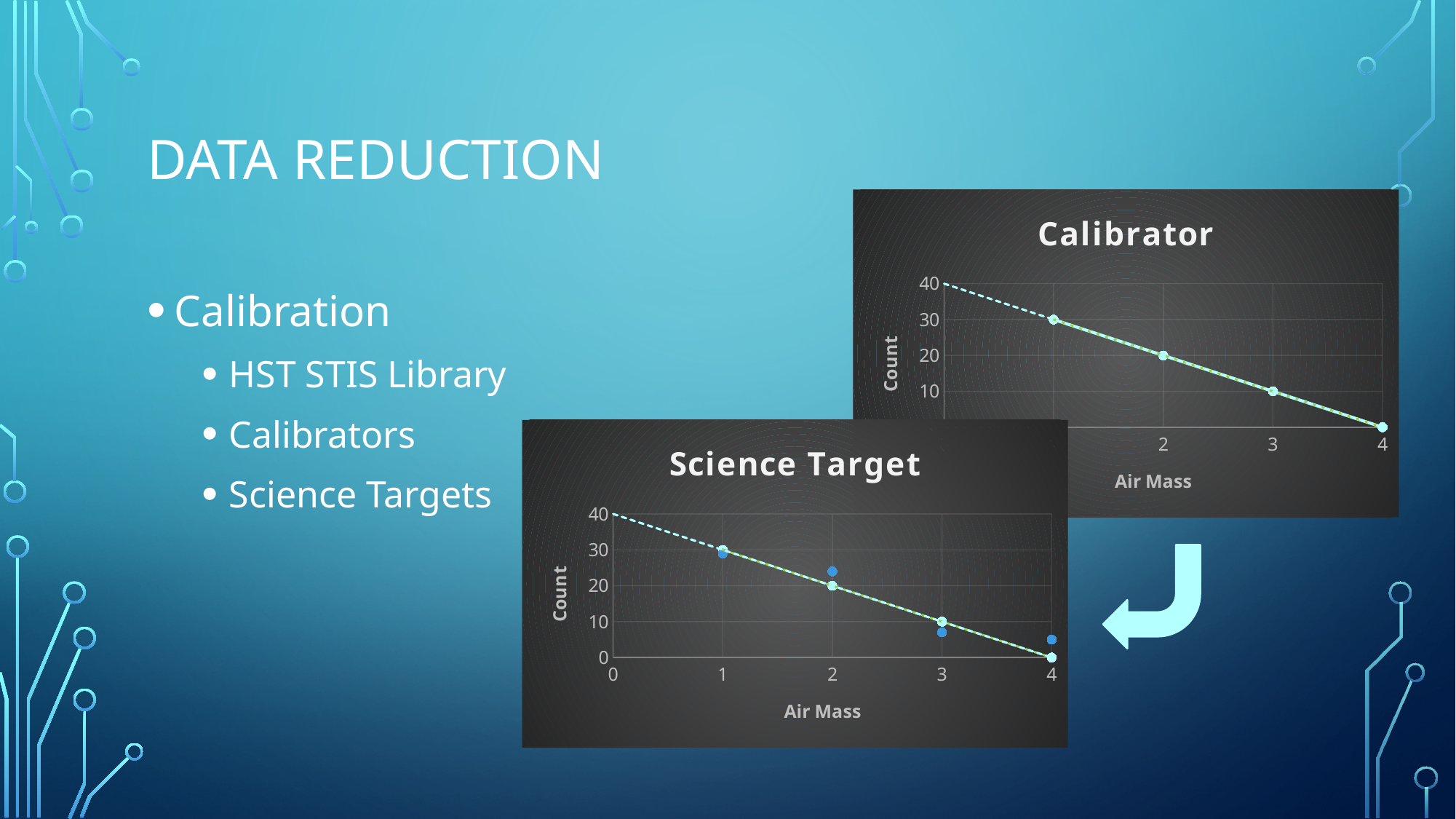
What is the label of the y axis on the Calibrator chart? Count In the Science Target chart, is the blue data point at Air Mass 2 greater or less than 20? greater What kind of chart is the Calibrator chart? line chart In the Science Target chart, is the blue data point at Air Mass 3 greater or less than 10? less In the Calibrator chart, does the Count rise or fall as Air Mass increases? fall In the Calibrator chart, what is the Count at Air Mass 3? 10 In the Calibrator chart, what is the difference in Count between Air Mass 2 and Air Mass 3? 10 What is the label of the x axis on the Science Target chart? Air Mass In the Science Target chart, which is larger: the Count of the fitted line point at Air Mass 1 or at Air Mass 3? Air Mass 1 In the Science Target chart, what is the Count of the fitted line point at Air Mass 1? 30 In the Science Target chart, what is the Count of the fitted line point at Air Mass 4? 0 In the Calibrator chart, what is the Count at Air Mass 2? 20